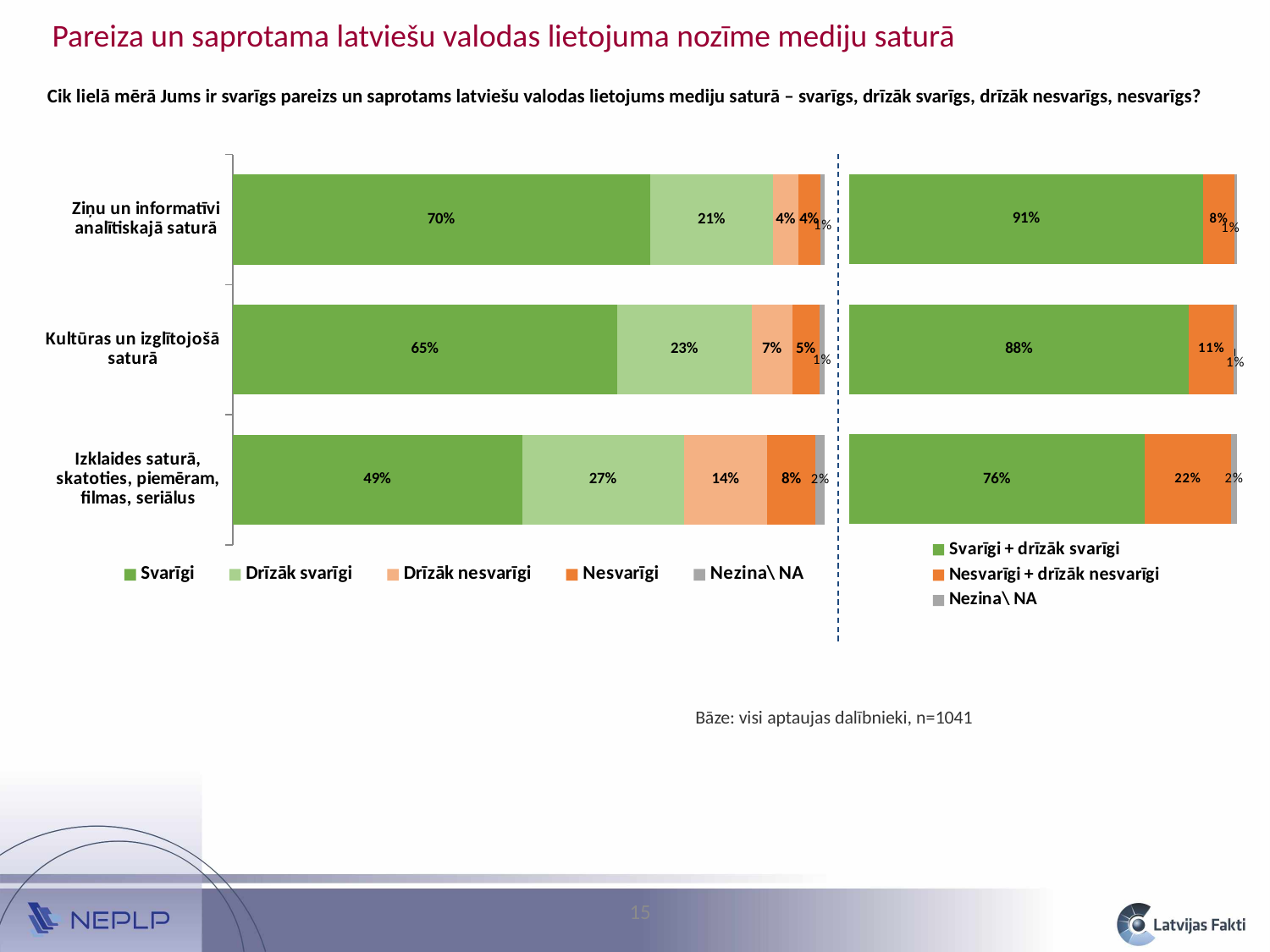
In the left chart, is the 'Drīzāk svarīgi' value larger for 'Kultūras un izglītojošā saturā' or for 'Izklaides saturā, skatoties, piemēram, filmas, seriālus'? Izklaides saturā, skatoties, piemēram, filmas, seriālus In the left chart, what is the difference between the 'Svarīgi' values for 'Ziņu un informatīvi analītiskajā saturā' and 'Kultūras un izglītojošā saturā'? 5% How many categories are shown in the left chart? 3 How many series does the legend of the right chart list? 3 In the left chart, which category has the lowest 'Svarīgi' value? Izklaides saturā, skatoties, piemēram, filmas, seriālus In the left chart, what is the 'Svarīgi' value for 'Ziņu un informatīvi analītiskajā saturā'? 70% In the right chart, which category has the highest 'Svarīgi + drīzāk svarīgi' value? Ziņu un informatīvi analītiskajā saturā In the left chart, what is the 'Drīzāk nesvarīgi' value for 'Izklaides saturā, skatoties, piemēram, filmas, seriālus'? 14% In the right chart, what is the difference between the 'Nesvarīgi + drīzāk nesvarīgi' values for 'Izklaides saturā, skatoties, piemēram, filmas, seriālus' and 'Ziņu un informatīvi analītiskajā saturā'? 14% How many series does the legend of the left chart list? 5 What type of chart is the right chart? Stacked bar chart In the right chart, what is the 'Svarīgi + drīzāk svarīgi' value for 'Kultūras un izglītojošā saturā'? 88%